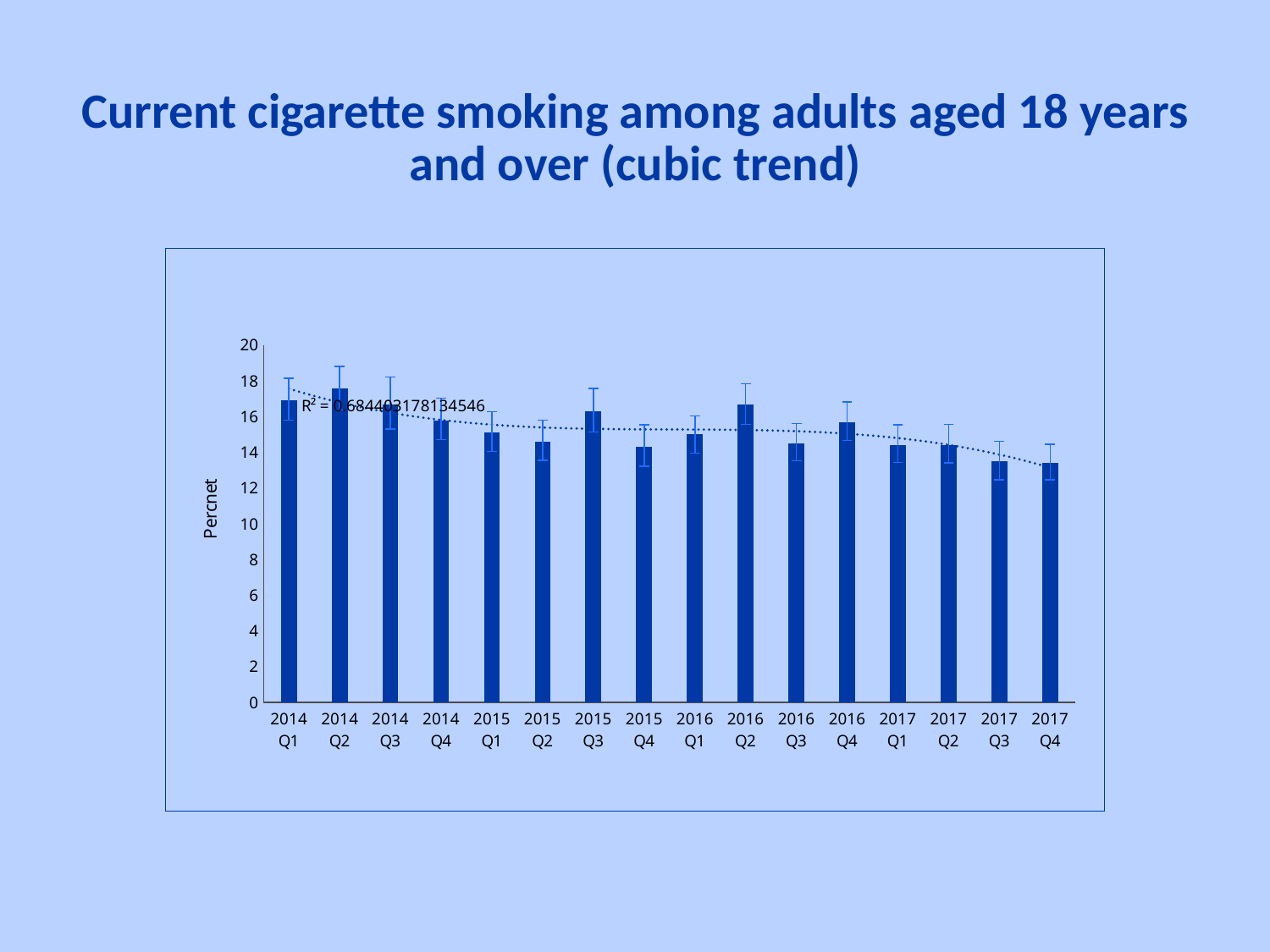
Which is larger, the value for 2014 Q2 or the value for 2017 Q4? 2014 Q2 Which is larger, the value for 2015 Q3 or the value for 2015 Q4? 2015 Q3 Is the value for 2015 Q4 greater or less than 16? less Is the value for 2014 Q1 greater or less than 16? greater How many quarterly bars are plotted in the chart? 16 What is the label on the vertical axis of the chart? Percnet Which quarter has the highest smoking percentage in the chart? 2014 Q2 Is the value for 2017 Q4 greater or less than 14? less Overall, do the smoking percentages rise or fall from 2014 Q1 to 2017 Q4? fall What kind of chart is shown on the slide? bar chart